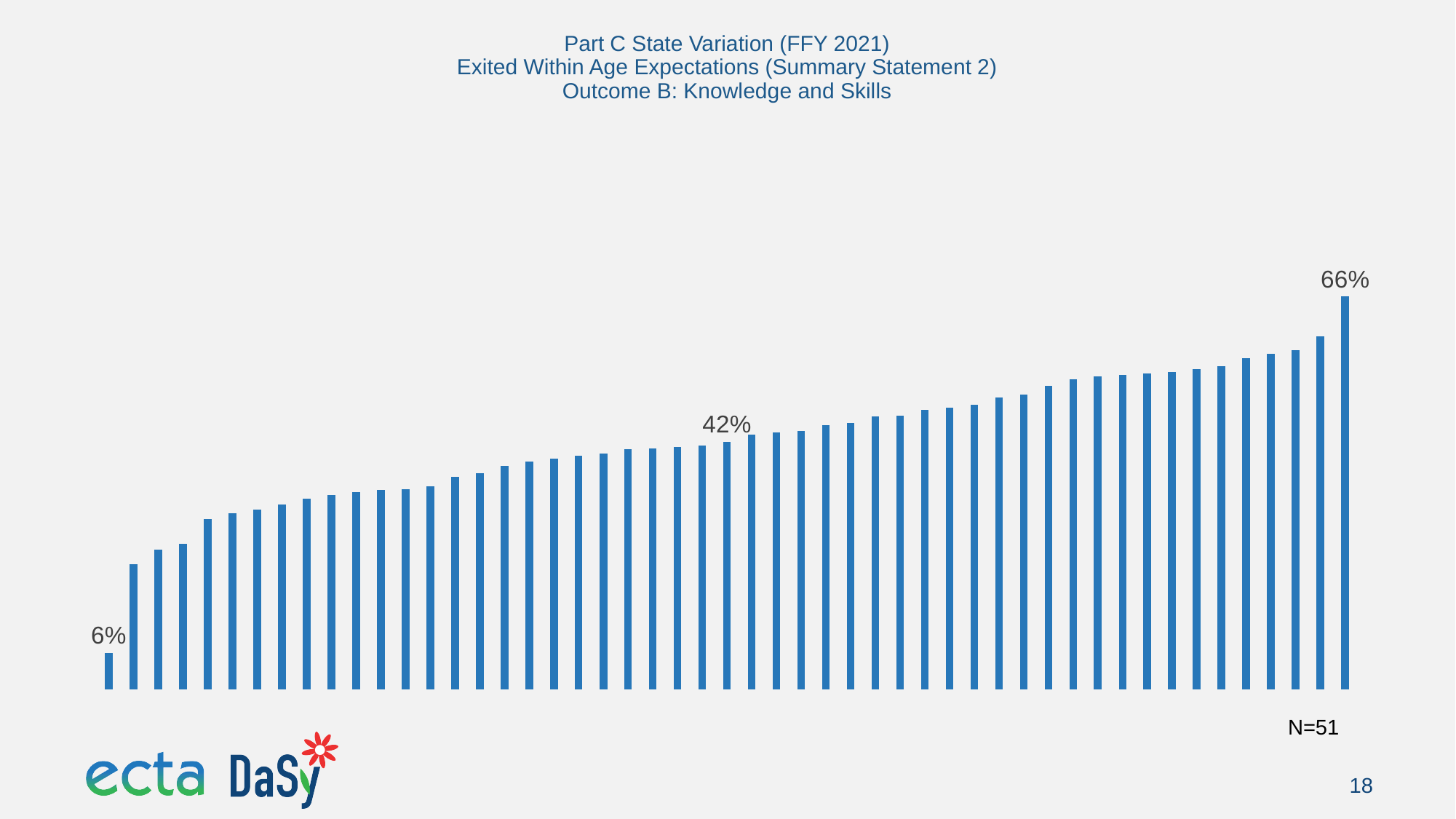
How many states (N) does the chart represent? 51 Which is larger, the value of the leftmost bar or the value of the rightmost bar? The rightmost bar What value is labeled on the middle bar of the chart? 42% Which federal fiscal year does the chart title refer to? FFY 2021 What is the difference between the middle labeled value and the lowest labeled value? 36 percentage points What is the difference between the highest and lowest values labeled on the chart? 60 percentage points Do the bar values rise or fall from left to right across the chart? Rise What kind of chart is shown on the slide? Bar chart What is the highest value shown on the chart? 66% Which outcome does the chart title say the data is for? Outcome B: Knowledge and Skills What is the lowest value shown on the chart? 6%